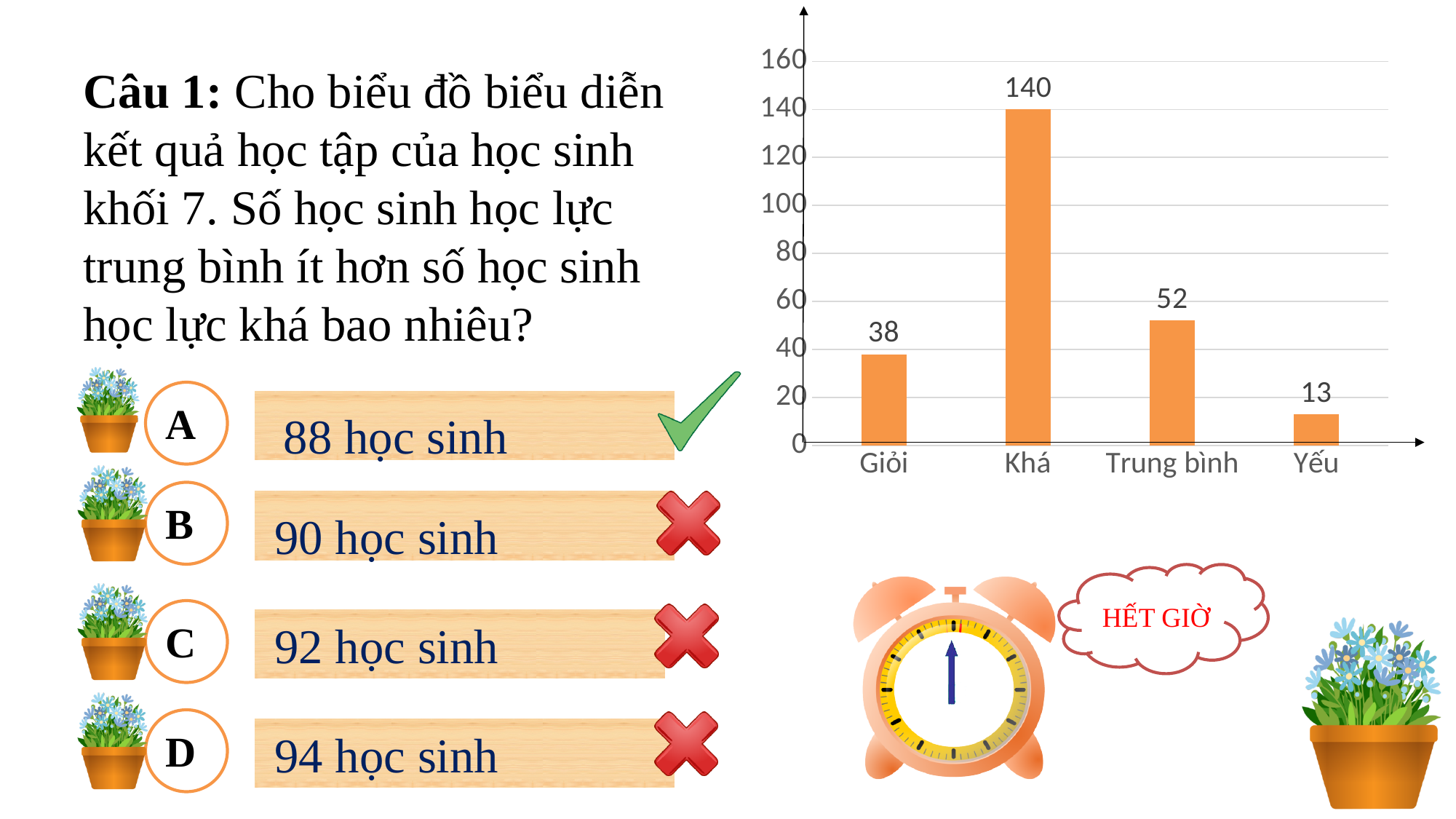
Which category has the highest value? Khá What is the difference between the values for Khá and Trung bình? 88 What is the value for Trung bình? 52 Which category has the lowest value? Yếu Which is larger, the value for Giỏi or the value for Trung bình? Trung bình How many categories are shown on the x axis? 4 Is the value for Khá greater or less than 120? greater What kind of chart is shown on the slide? bar chart What is the value for Yếu? 13 What is the value for Giỏi? 38 What is the difference between the values for Trung bình and Giỏi? 14 What is the value for Khá? 140